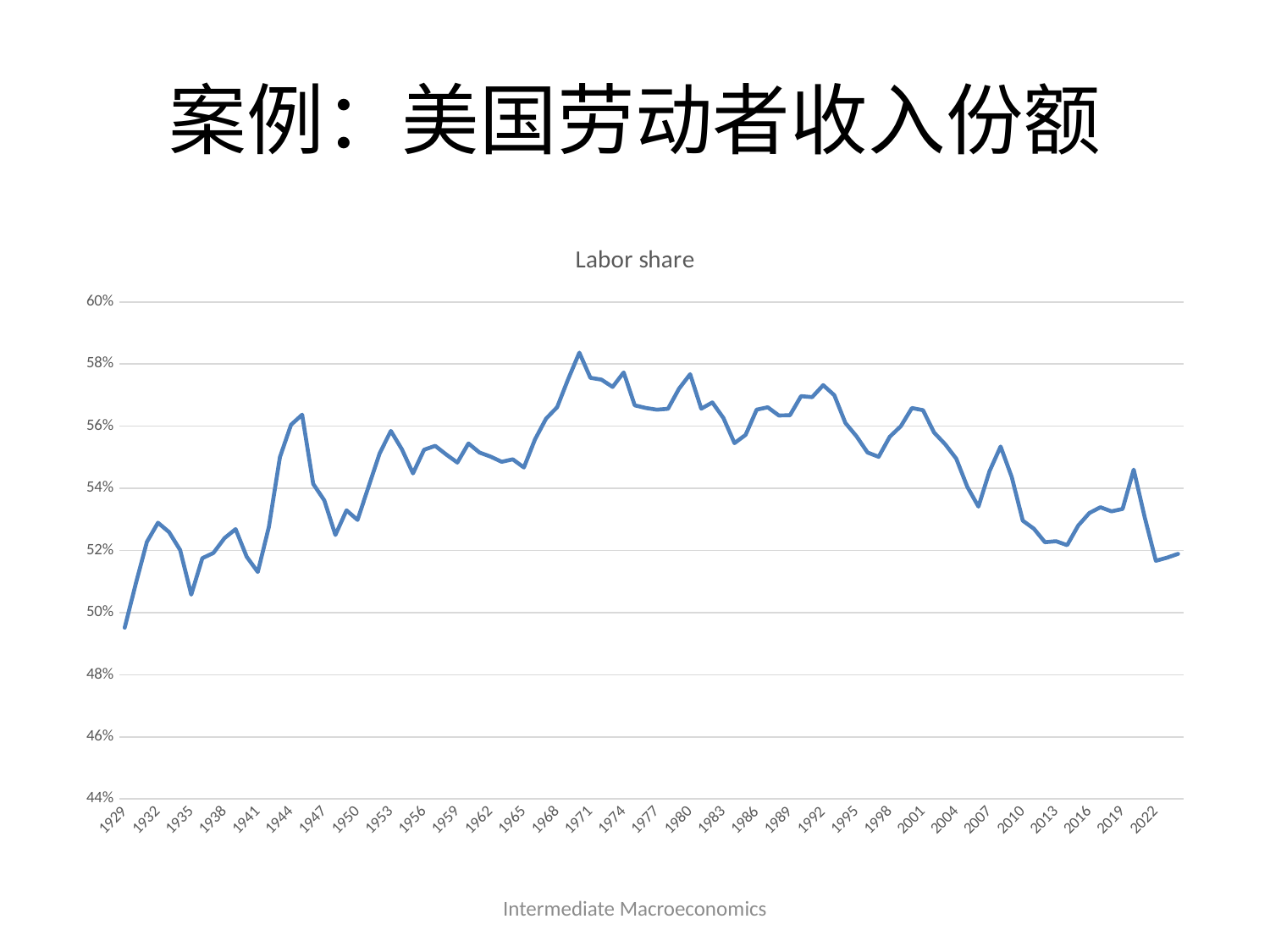
Is the value for 1935 greater or less than 52%? less Is the value for 1929 greater or less than 50%? less Which is larger, the labor share in 1970 or in 2022? 1970 What is the title of the chart? Labor share Does the labor share generally rise or fall between 1970 and 2022? fall Is the value for 1992 greater or less than 56%? greater What kind of chart is shown on the slide? line chart Does the labor share generally rise or fall between 1929 and 1970? rise